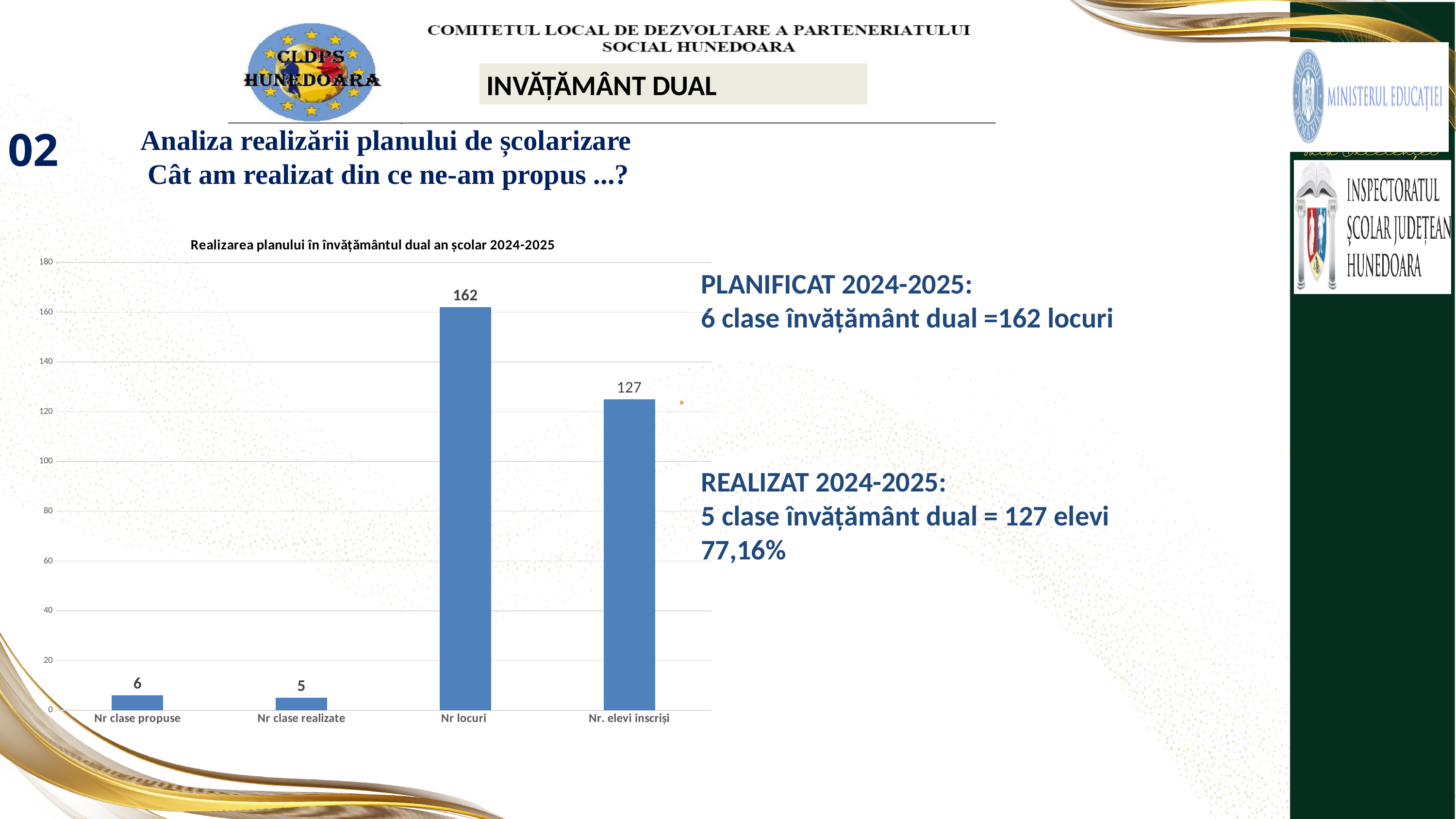
Is the value for Nr. elevi inscriși greater or less than 140? less What is the title of the chart? Realizarea planului în învățământul dual an școlar 2024-2025 How many categories are shown on the x axis? 4 What is the value for Nr clase propuse? 6 Which category has the lowest value? Nr clase realizate Which is larger, Nr clase propuse or Nr clase realizate? Nr clase propuse What is the value for Nr. elevi inscriși? 127 Which category has the highest value? Nr locuri What is the value for Nr locuri? 162 What kind of chart is shown on the slide? bar chart What is the value for Nr clase realizate? 5 What is the difference between Nr locuri and Nr. elevi inscriși? 35